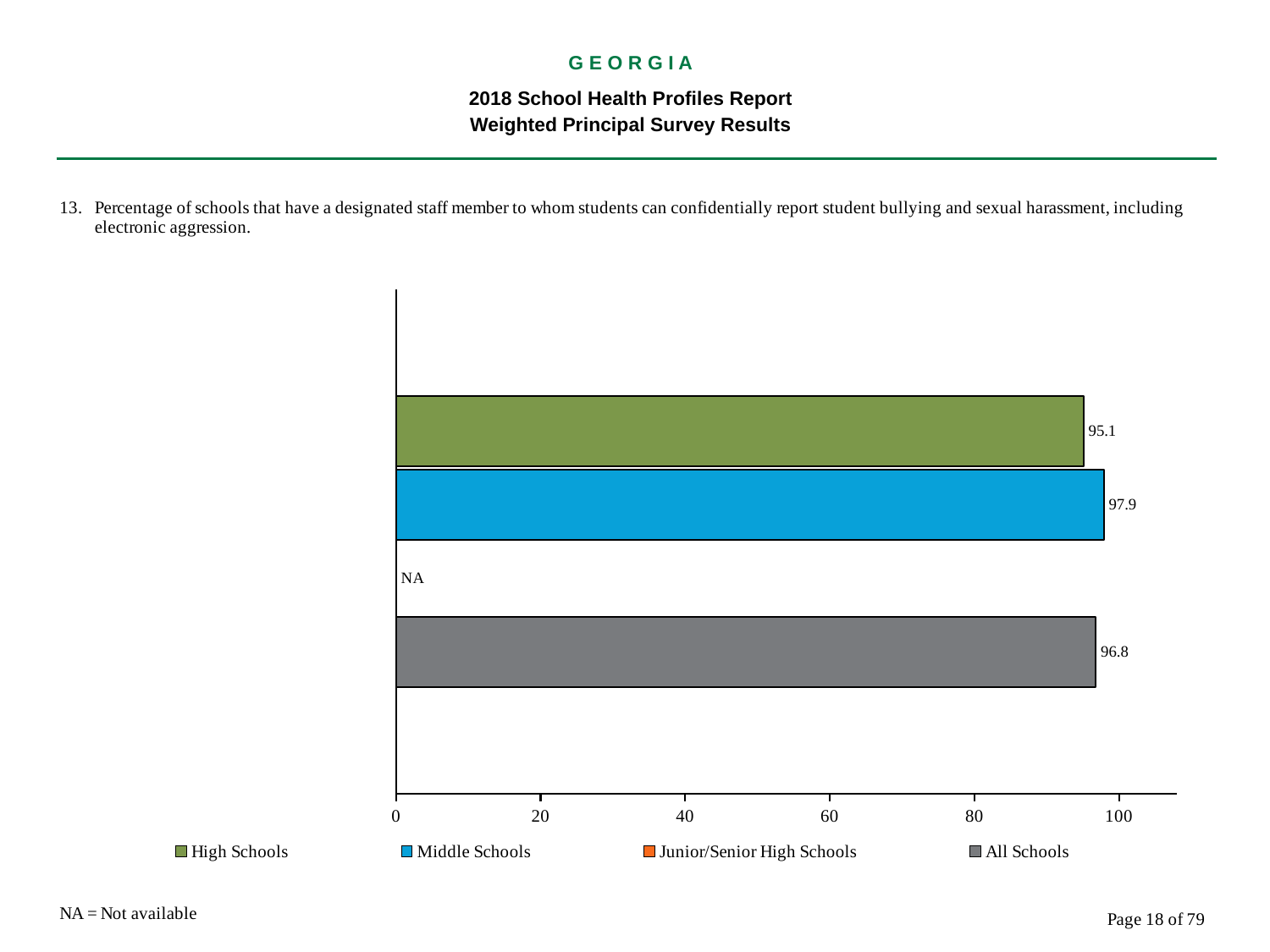
Is the value for Middle Schools greater or less than 80? greater Which school type has the highest value? Middle Schools What does NA stand for according to the note on the slide? Not available Among the school types with a plotted value, which has the lowest value? High Schools What is shown for Junior/Senior High Schools? NA What is the difference between the Middle Schools value and the High Schools value? 2.8 What is the value for High Schools? 95.1 What is the value for All Schools? 96.8 How many series does the legend list? 4 What is the value for Middle Schools? 97.9 Which is larger, the value for All Schools or the value for High Schools? All Schools What kind of chart is this? bar chart